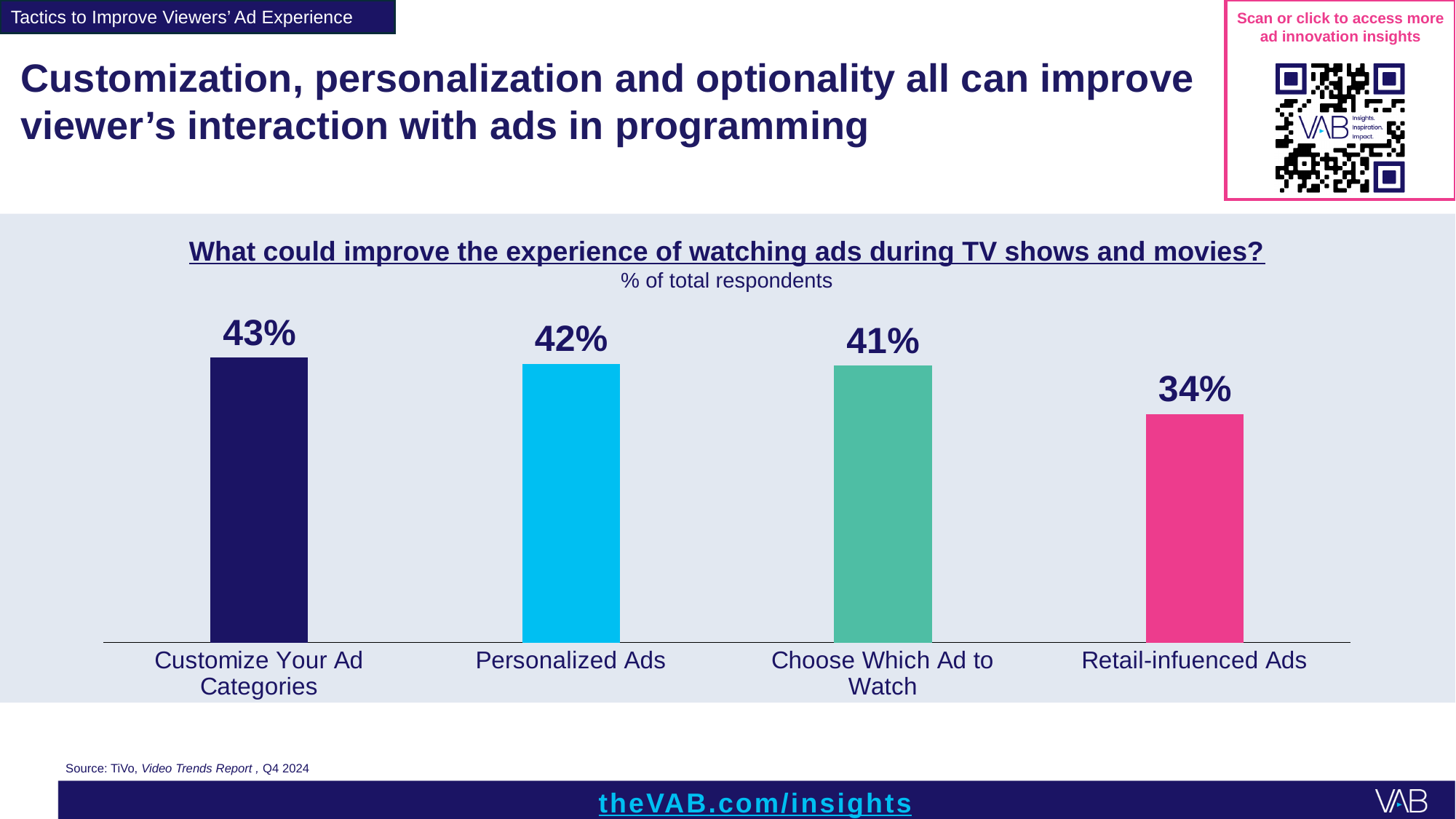
How many categories are shown in the chart? 4 What is the value shown for Personalized Ads? 42% What percentage of respondents said Customize Your Ad Categories could improve the experience of watching ads? 43% Which category has the lowest percentage of respondents? Retail-infuenced Ads Which category has the highest percentage of respondents? Customize Your Ad Categories Do the values rise or fall moving from left to right across the chart? Fall What percentage of respondents chose Choose Which Ad to Watch? 41% What is the value for Retail-infuenced Ads? 34% What is the difference between Personalized Ads and Choose Which Ad to Watch? 1 percentage point Which is larger: the value for Choose Which Ad to Watch or the value for Retail-infuenced Ads? Choose Which Ad to Watch What is the difference in percentage points between Customize Your Ad Categories and Retail-infuenced Ads? 9 percentage points What type of chart is shown on the slide? Bar chart